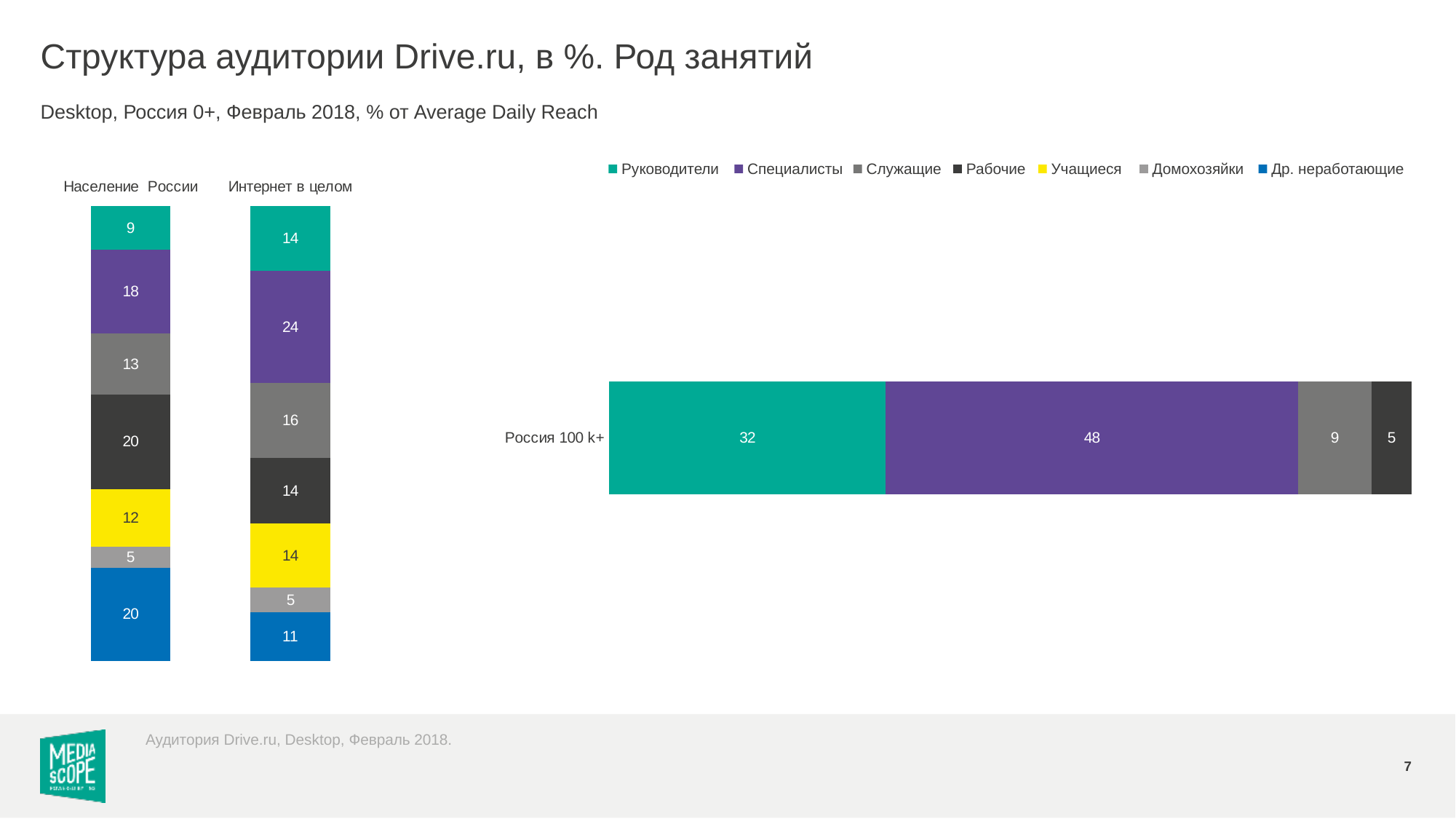
In the right chart (Россия 100 k+), which occupation group has the largest share? Специалисты In the left chart, what is the value for Руководители in the Интернет в целом bar? 14 In the left chart, which is larger: Специалисты for Население России or Специалисты for Интернет в целом? Интернет в целом In the right chart (Россия 100 k+), what is the difference between the values for Специалисты and Руководители? 16 In the left chart, which occupation group has the smallest value in the Интернет в целом bar? Домохозяйки In the left chart, what is the value for Др. неработающие in the Население России bar? 20 In the right chart (Россия 100 k+), what is the total of the four labelled segments? 94 What kind of chart is shown on the right side of the slide? Stacked bar chart In the left chart, what is the value for Специалисты in the Население России bar? 18 In the right chart (Россия 100 k+), what is the value for Руководители? 32 In the right chart (Россия 100 k+), what is the value for Специалисты? 48 How many series does the legend list? 7